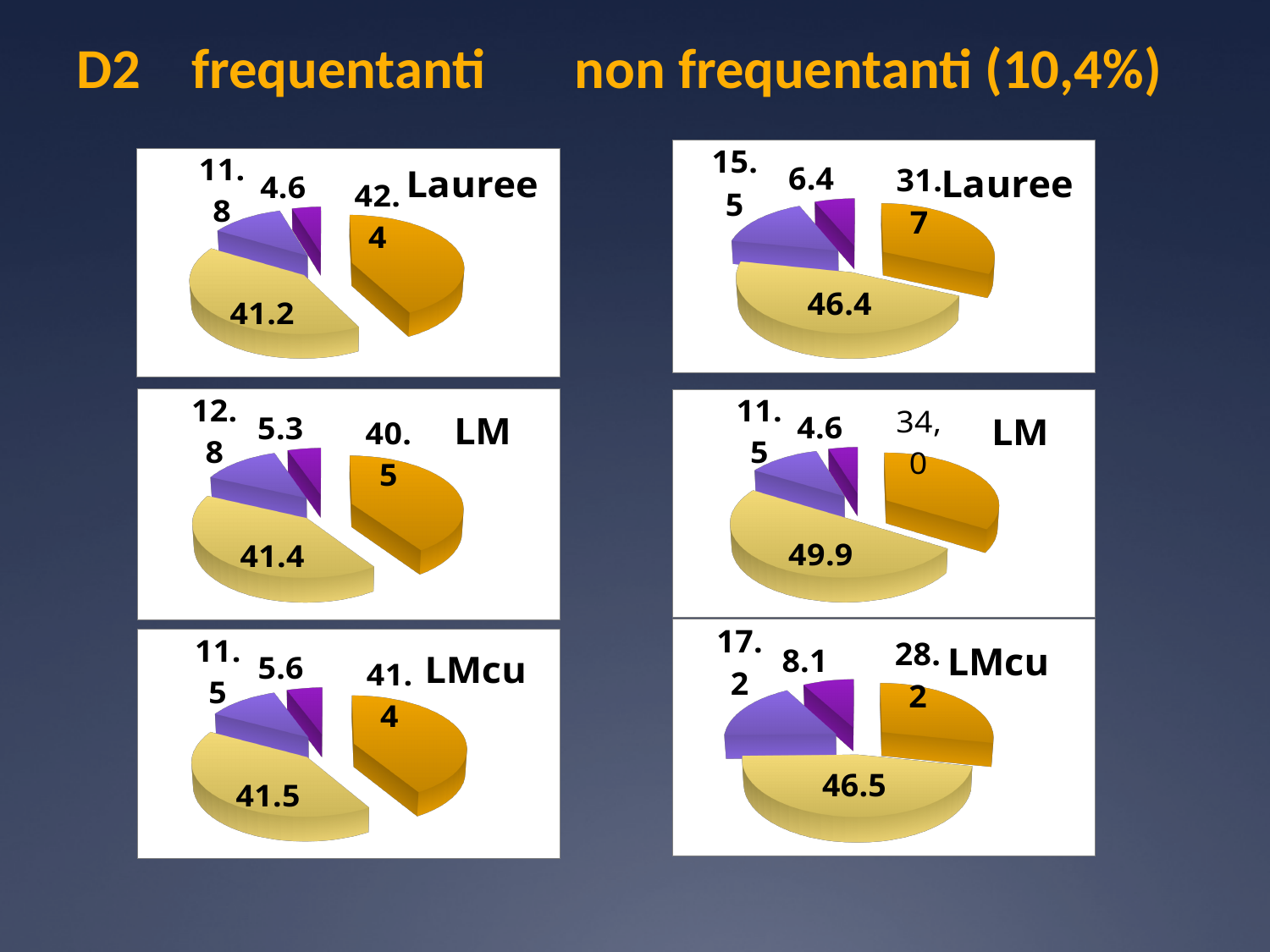
What kind of chart is used for the 'Lauree' chart in the frequentanti column? pie chart In the non frequentanti 'LMcu' pie chart, which is larger: the light purple slice or the dark purple slice? the light purple slice (17.2) In the non frequentanti 'LMcu' pie chart, what value is shown on the dark purple slice? 8.1 In the frequentanti 'LM' pie chart, what value is shown on the dark purple slice? 5.3 In the non frequentanti 'LM' pie chart, what value is shown on the light yellow slice? 49.9 In the non frequentanti 'LM' pie chart, which slice has the smallest value? the dark purple slice (4.6) In the non frequentanti 'Lauree' pie chart, what is the difference between the light yellow slice (46.4) and the orange slice (31.7)? 14.7 In the non frequentanti 'Lauree' pie chart, what value is shown on the light yellow slice? 46.4 How many slices does the frequentanti 'LMcu' pie chart have? 4 How many pie charts are shown on the slide in total? 6 In the non frequentanti 'LMcu' pie chart, which slice has the largest value? the light yellow slice (46.5) In the frequentanti 'Lauree' pie chart, what value is shown on the light yellow slice? 41.2